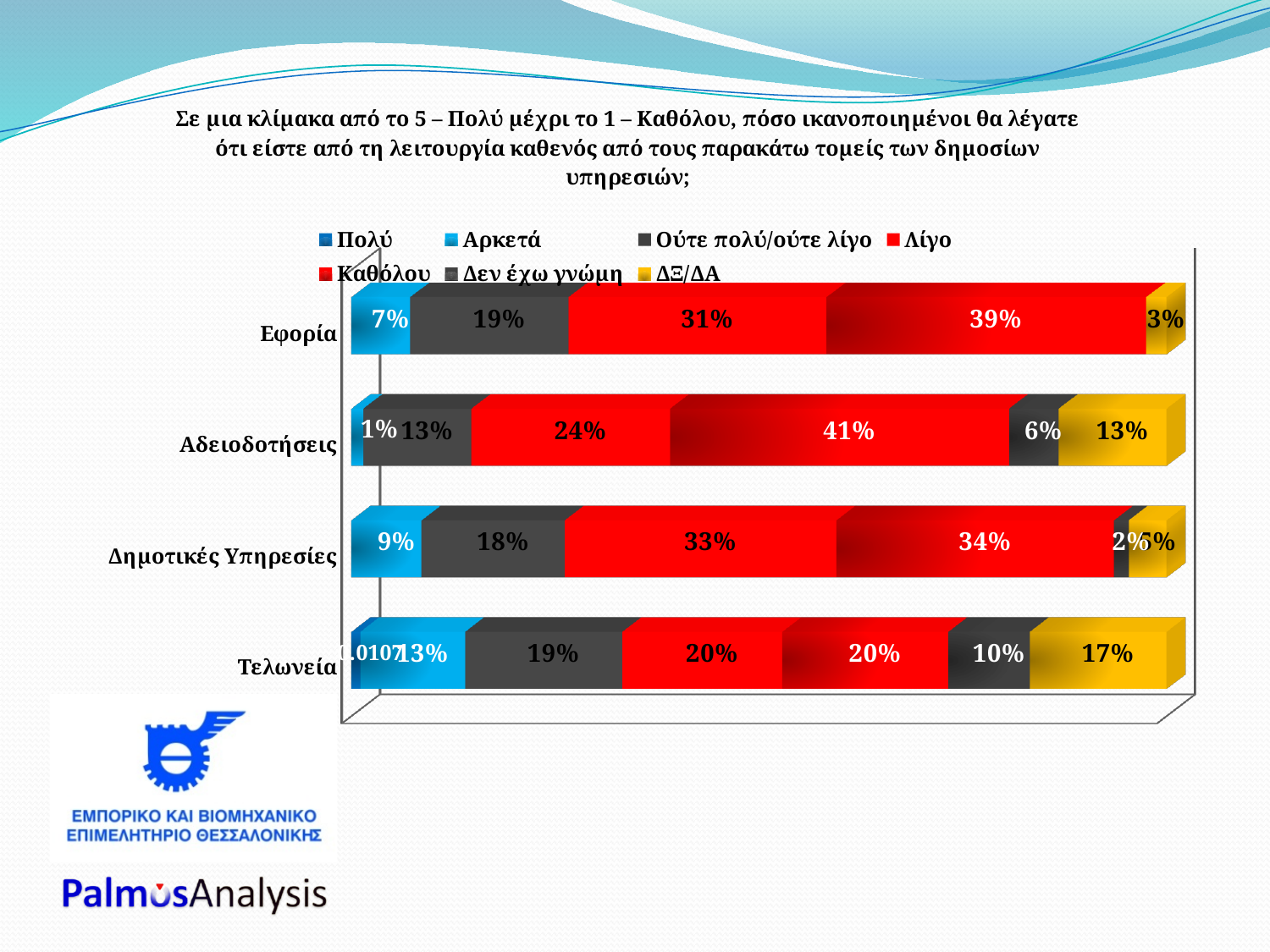
What is the Καθόλου value for Εφορία? 39% What type of chart is shown on the slide? stacked bar chart What is the Αρκετά value for Δημοτικές Υπηρεσίες? 9% What is the difference between the Καθόλου value for Αδειοδοτήσεις and the Καθόλου value for Εφορία? 2% Which is larger: the Ούτε πολύ/ούτε λίγο value for Εφορία or for Αδειοδοτήσεις? Εφορία What is the ΔΞ/ΔΑ value for Τελωνεία? 17% How many categories (public service sectors) are shown on the chart? 4 What is the Λίγο value for Αδειοδοτήσεις? 24% Which category has the highest Καθόλου value? Αδειοδοτήσεις Which legend entry is shown in yellow? ΔΞ/ΔΑ How many series does the legend list? 7 Which category has the lowest Λίγο value? Τελωνεία